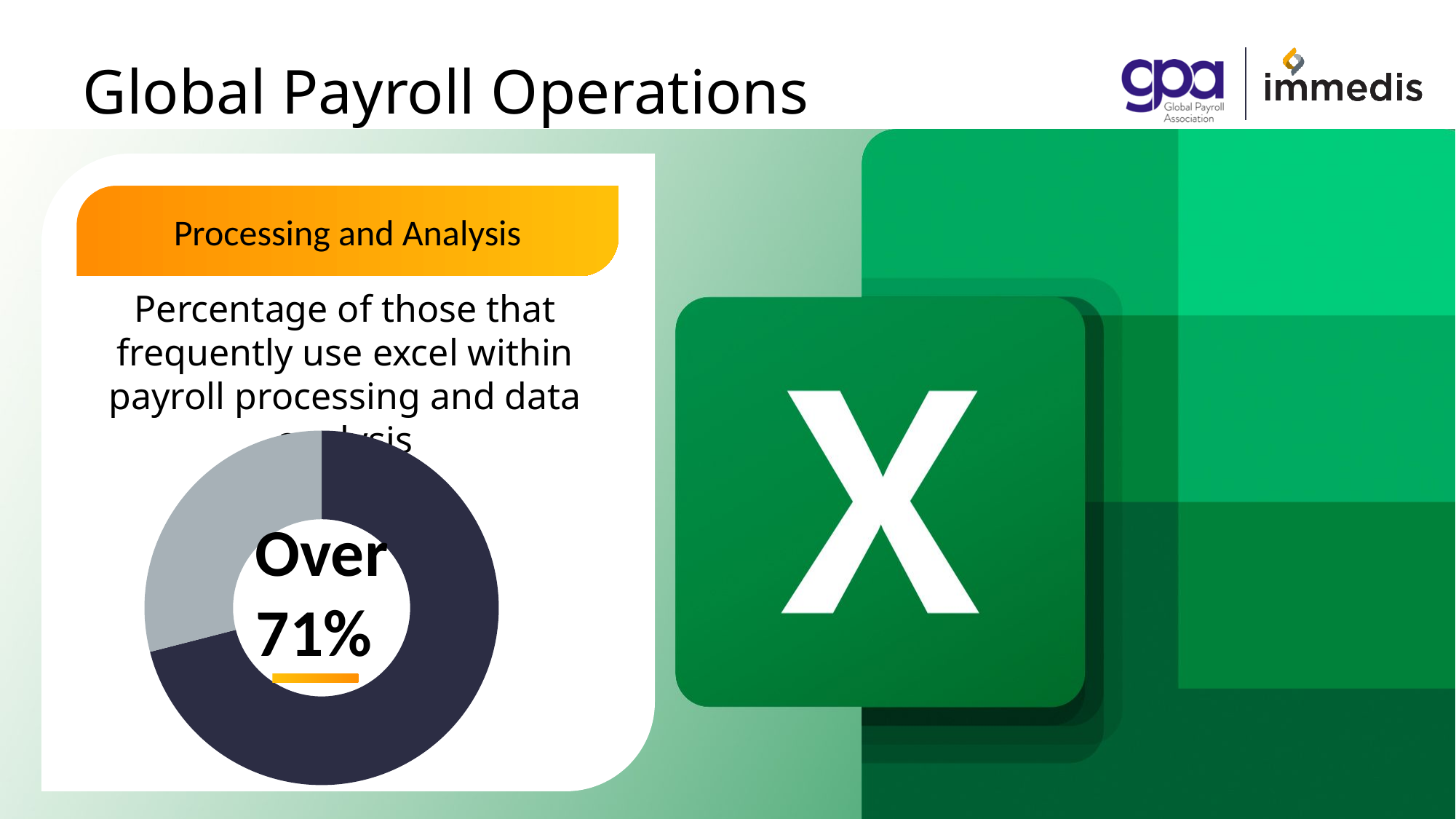
What kind of chart is shown on the slide? pie chart (donut) What percentage of respondents frequently use Excel within payroll processing and data analysis, according to the chart? Over 71% Does the dark navy slice cover more or less than half of the donut chart? more Which slice of the donut chart is larger, the dark navy one or the grey one? the dark navy one What is the heading of the orange banner above the chart? Processing and Analysis How many slices does the donut chart have? 2 What two colours are used for the slices of the donut chart? dark navy and grey What value is printed in the centre of the donut chart? Over 71% Which slice of the donut chart is the smallest? the grey slice